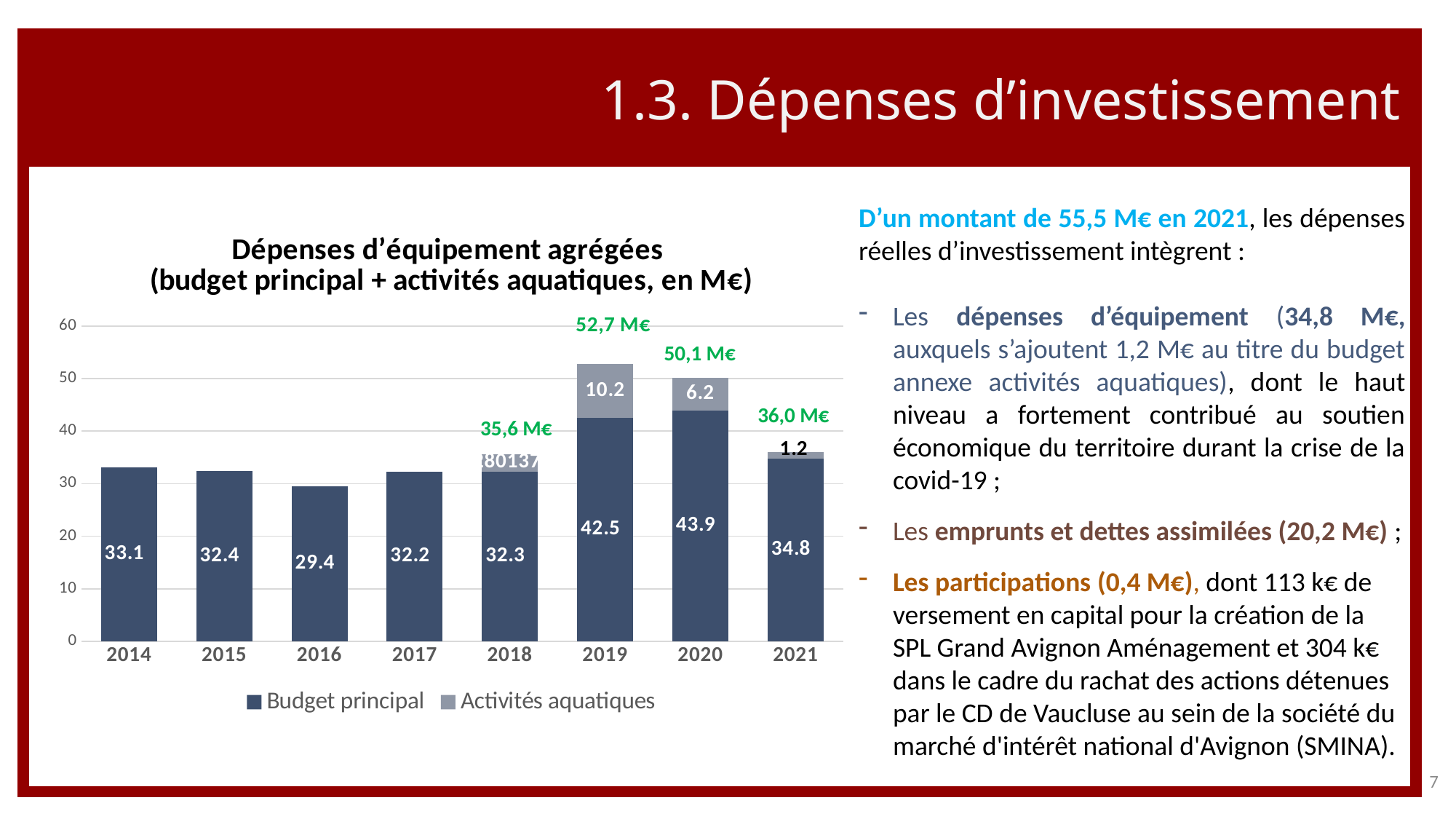
Which year has the highest Budget principal value? 2020 Is the total stacked bar for 2019 greater or less than 50? greater Which year has the lowest Budget principal value? 2016 What is the total of the stacked bar for 2020, as labelled above it? 50,1 M€ What is the Budget principal value for 2021? 34.8 How many series does the legend list? 2 What is the difference between the Budget principal values for 2020 and 2019? 1.4 How many years are shown on the x axis? 8 What kind of chart is shown on the slide? Stacked bar chart What is the Activités aquatiques value for 2019? 10.2 Which is larger, the Activités aquatiques value for 2020 or for 2021? 2020 What is the Budget principal value for 2016? 29.4